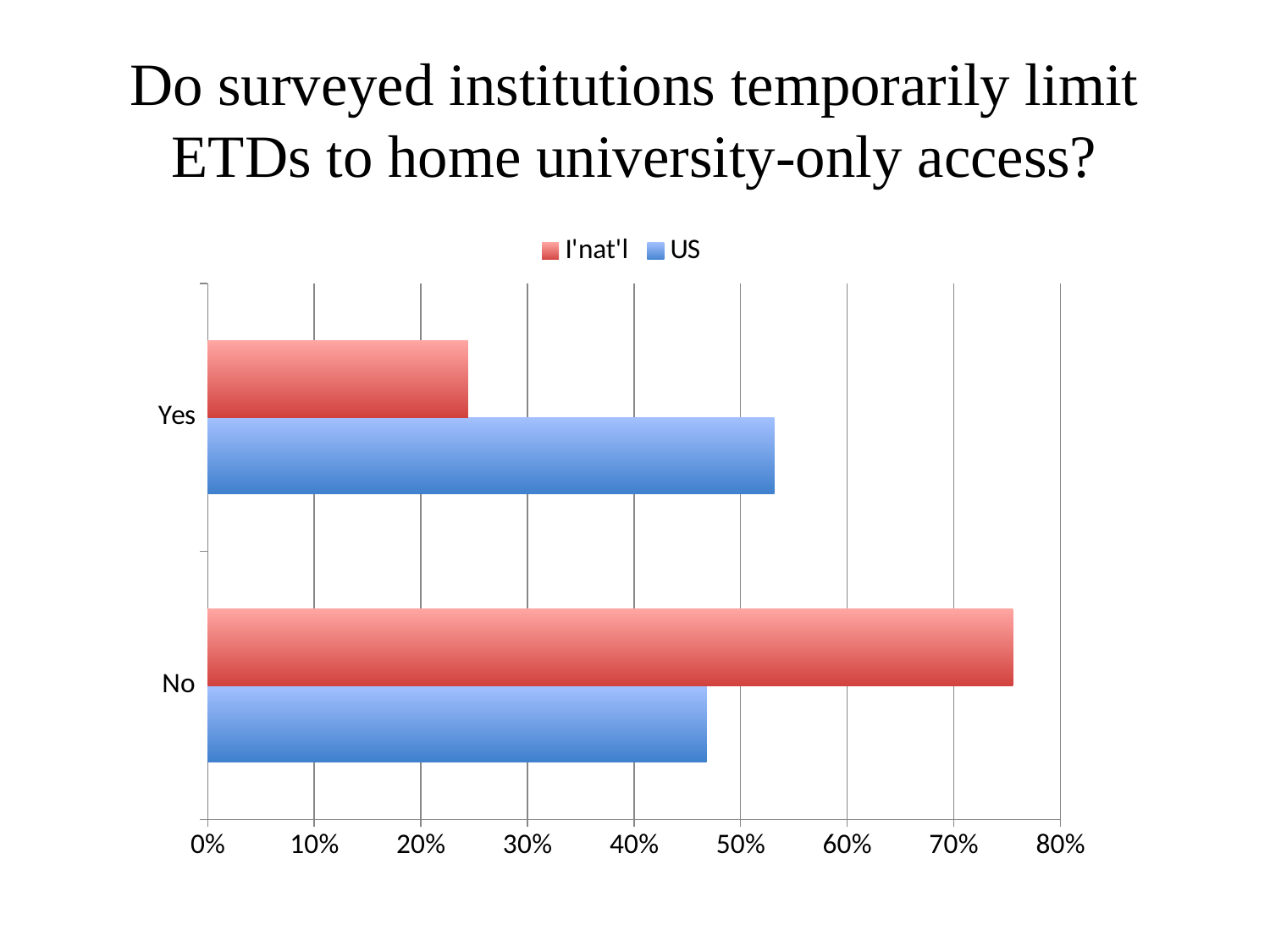
Is the US value for No greater or less than 50%? less Which series is shown in red? I'nat'l Is the I'nat'l value for Yes greater or less than 30%? less Is the US value for Yes greater or less than 50%? greater Which bar is the shortest in the chart? I'nat'l for Yes How many series does the legend list? 2 How many categories are shown on the vertical axis? 2 For the Yes category, which series has the larger value, I'nat'l or US? US For the No category, which series has the larger value, I'nat'l or US? I'nat'l What kind of chart is shown on the slide? bar chart Which category has the highest I'nat'l value? No